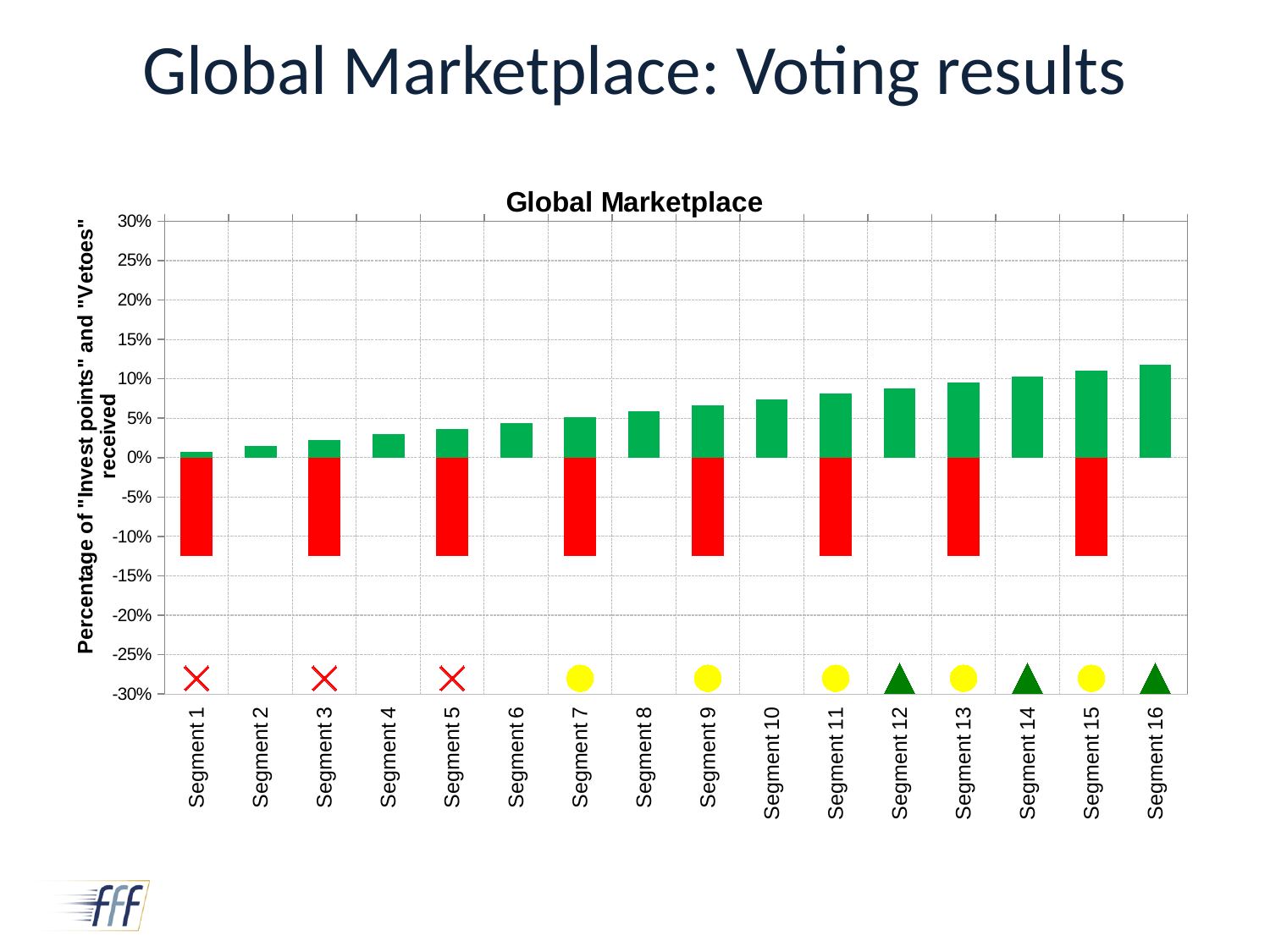
What is the title of the chart? Global Marketplace Is the green bar value for Segment 2 greater or less than 5%? less How many segments have a red bar below 0%? 8 Do the green bars rise or fall from Segment 1 to Segment 16? rise Is the green bar value for Segment 16 greater or less than 10%? greater Which segment has the tallest green bar? Segment 16 Which segment has the shortest green bar? Segment 1 Which has the larger green bar, Segment 4 or Segment 12? Segment 12 How many segments are shown on the x axis of the chart? 16 What kind of chart is shown on the slide? bar chart What is the label of the vertical axis? Percentage of "Invest points" and "Vetoes" received Is the green bar value for Segment 10 greater or less than 5%? greater